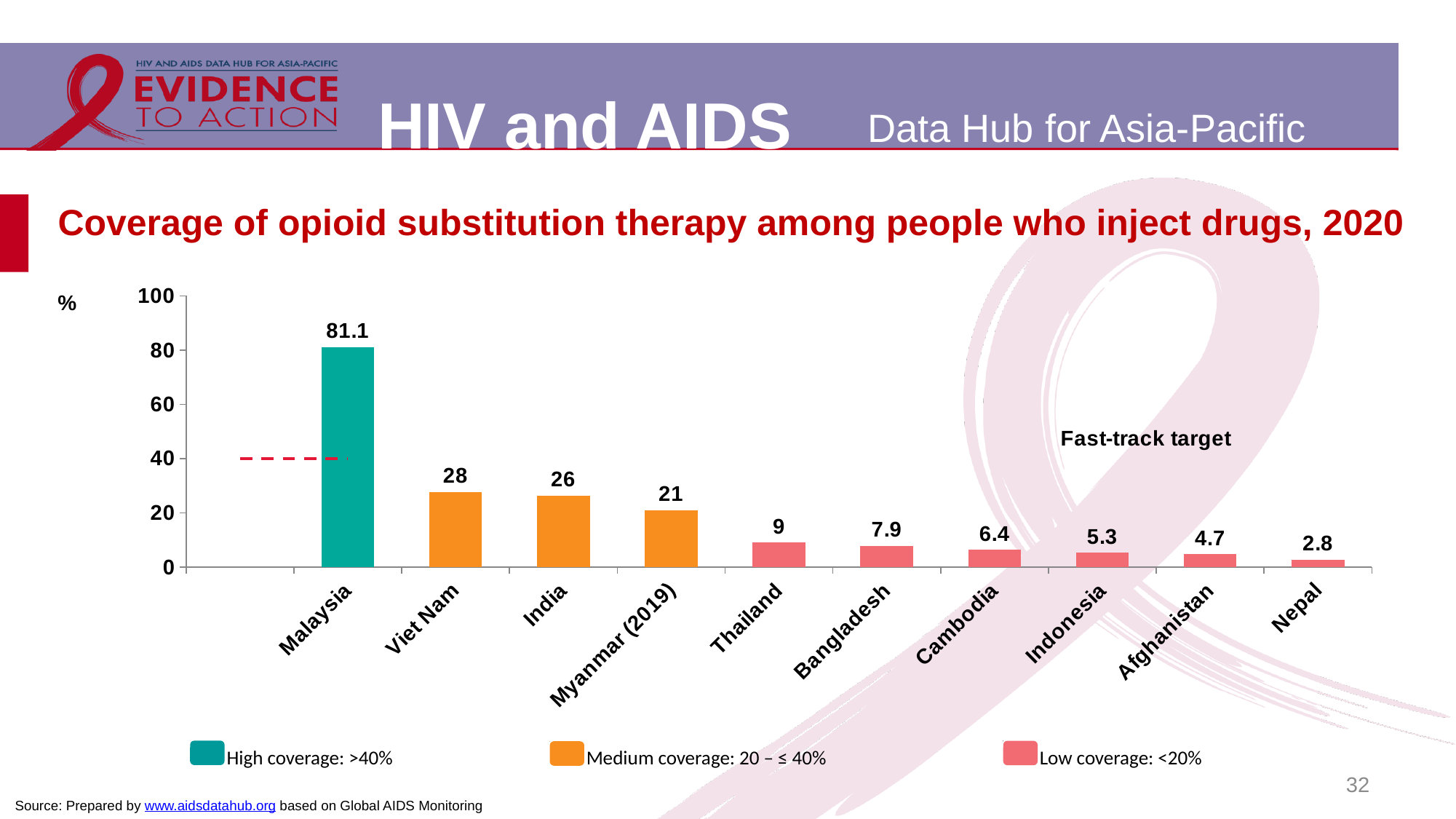
What is the difference between the values for Viet Nam and India? 2 How many countries are shown on the chart? 10 What does the dashed line on the chart represent? Fast-track target What is the value shown for Myanmar (2019)? 21 Which country has the highest coverage? Malaysia What type of chart is shown? Bar chart How many coverage categories does the legend list? 3 Which has a higher value, Thailand or Cambodia? Thailand What is the coverage of opioid substitution therapy for Malaysia? 81.1 Which country has the lowest coverage? Nepal What is the value shown for Viet Nam? 28 What is the value shown for Bangladesh? 7.9